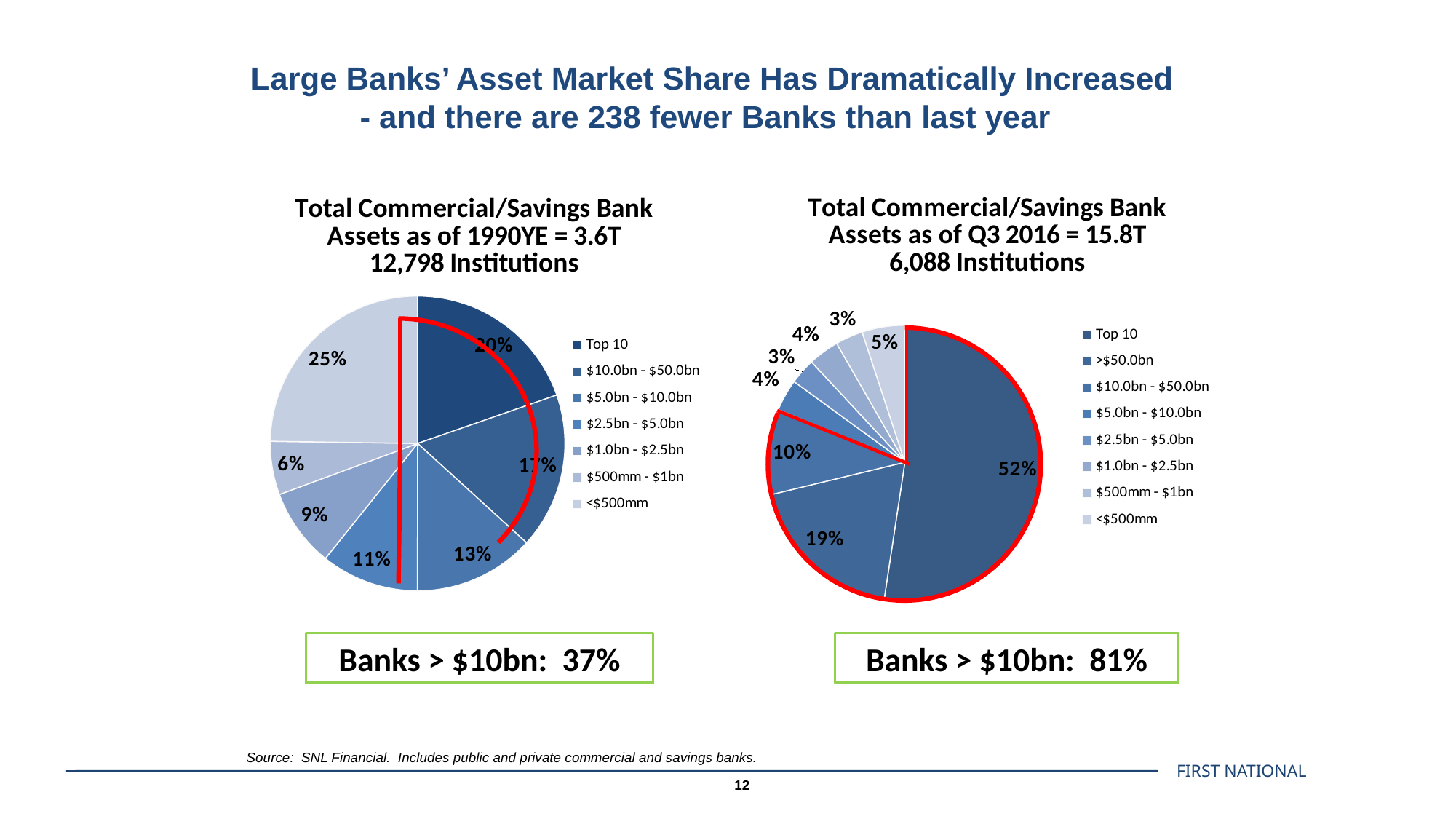
In the left pie chart (1990YE), which category has the largest share? <$500mm In the left pie chart (1990YE), what share of assets is held by banks with <$500mm in assets? 25% How many categories does the legend of the right pie chart (Q3 2016) list? 8 In the right pie chart (Q3 2016), which category has the largest share? Top 10 How many slices does the left pie chart (1990YE) have? 7 In the left pie chart (1990YE), what share of assets is held by the Top 10 banks? 20% By how many percentage points did the Top 10 share increase from the left chart (1990YE) to the right chart (Q3 2016)? 32 percentage points In the left pie chart (1990YE), which category has the smallest share? $500mm - $1bn In the right pie chart (Q3 2016), what share of assets is held by the Top 10 banks? 52% In the right pie chart (Q3 2016), what share of assets is held by banks with >$50.0bn in assets? 19% In the left pie chart (1990YE), which is larger: the $10.0bn - $50.0bn share or the $5.0bn - $10.0bn share? $10.0bn - $50.0bn What type of chart is used on this slide? Pie chart